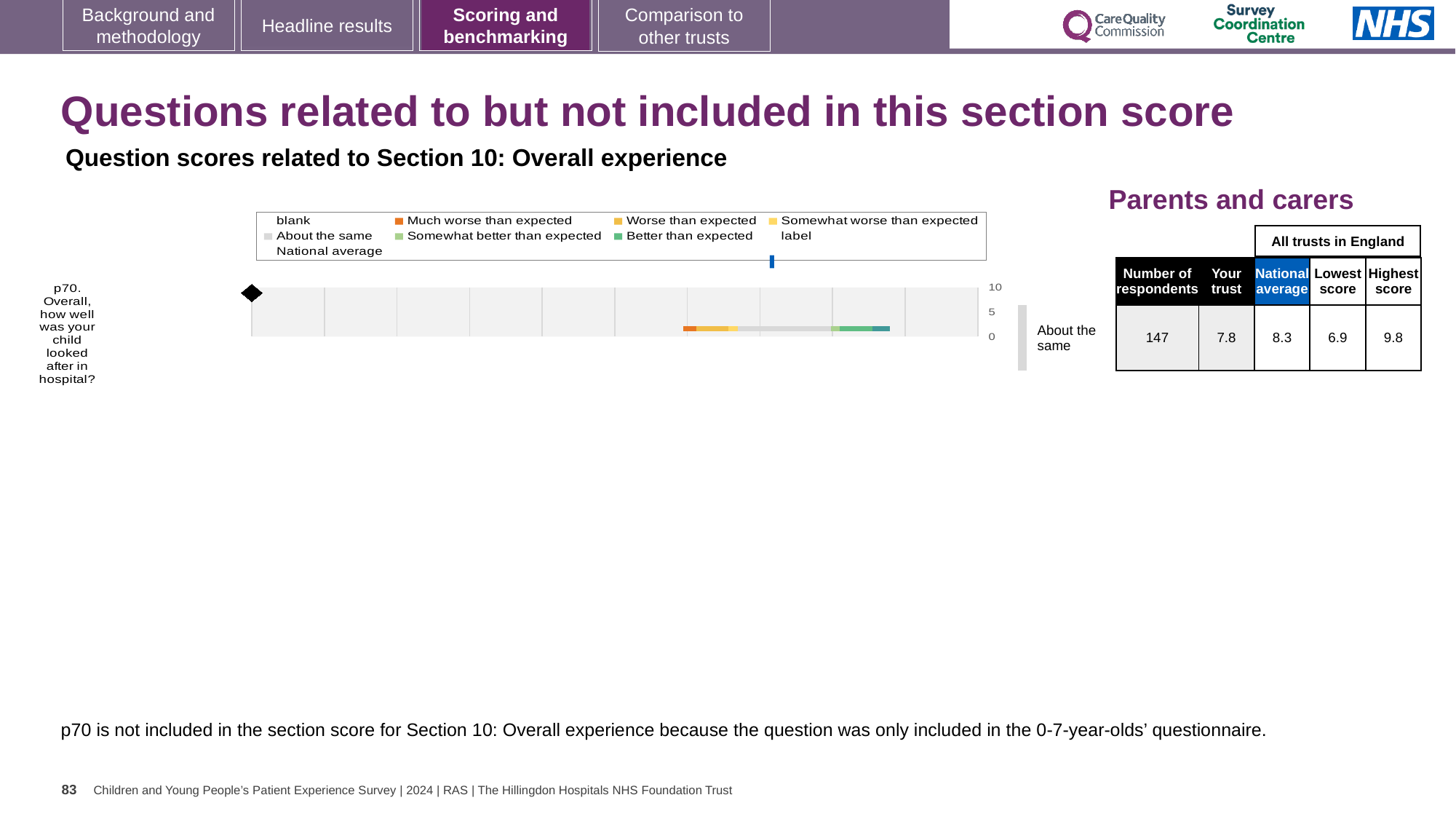
What kind of chart is used to show the benchmarking result for question p70? bar chart What benchmarking category is the trust's result for p70 placed in? About the same What is the 'Your trust' score for p70 in the Parents and carers table? 7.8 What is the difference between the Highest score and the Lowest score for p70? 2.9 How many questions are plotted in the chart? 1 What is the Highest score among all trusts in England for p70? 9.8 Which is larger for p70: the 'Your trust' score or the National average? National average What is the highest value shown on the chart's axis? 10 How many respondents answered p70 in the Parents and carers table? 147 What is the Lowest score among all trusts in England for p70? 6.9 What is the National average score for p70 in the Parents and carers table? 8.3 Which question is plotted in the chart? p70. Overall, how well was your child looked after in hospital?